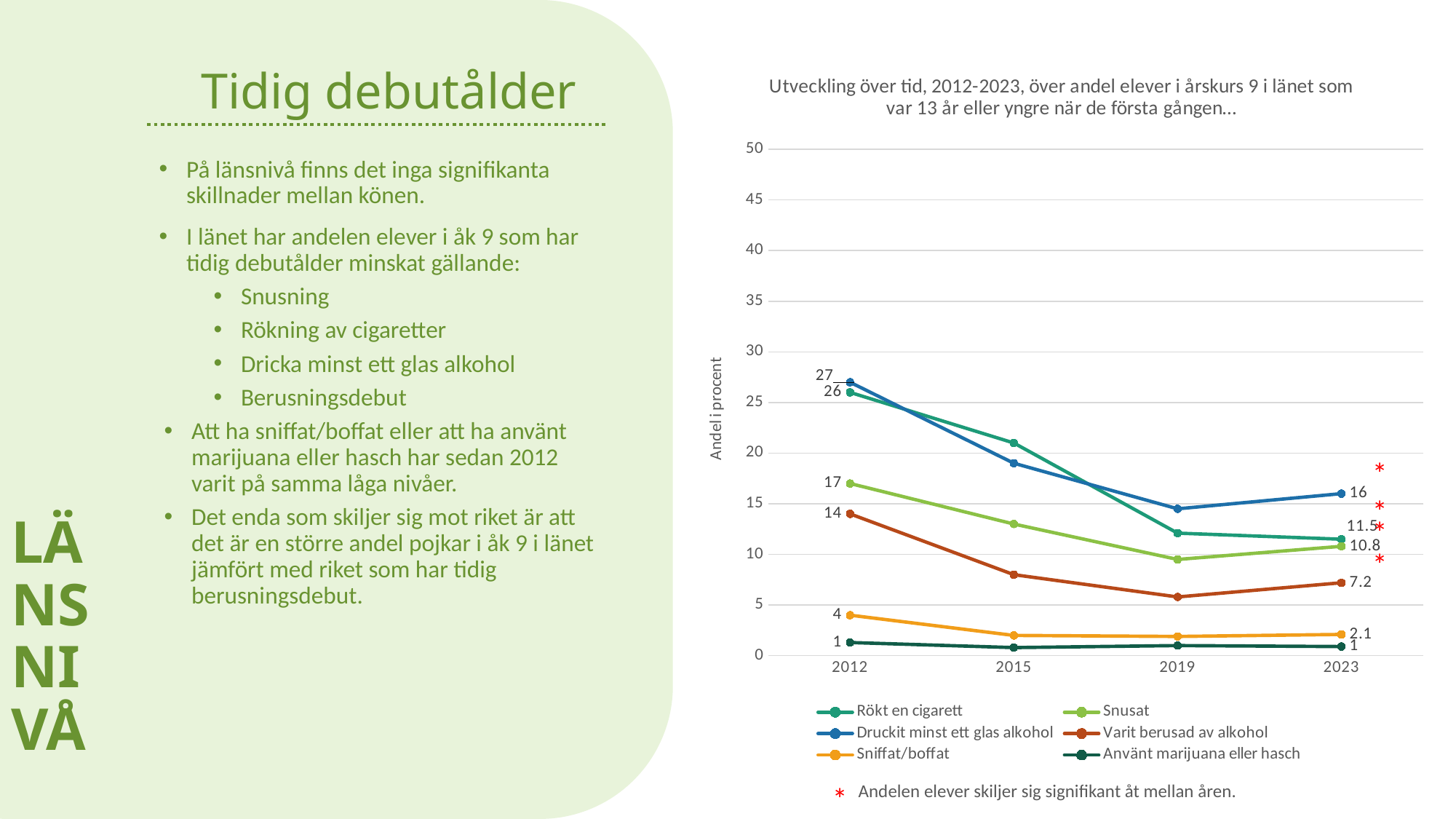
Is the value for 'Varit berusad av alkohol' in 2015 greater or less than 10? less What kind of chart is shown on the slide? line chart What is the value for 'Rökt en cigarett' in 2023? 11.5 Which series has the lowest value in 2023? Använt marijuana eller hasch What is the value for 'Sniffat/boffat' in 2023? 2.1 Which series has the highest value in 2012? Druckit minst ett glas alkohol What is the value for 'Druckit minst ett glas alkohol' in 2012? 27 What is the value for 'Snusat' in 2012? 17 By how much did 'Varit berusad av alkohol' fall from 2012 to 2023? 6.8 How many years are shown on the x axis? 4 Does the value for 'Snusat' rise or fall from 2012 to 2023? fall How many series does the legend list? 6